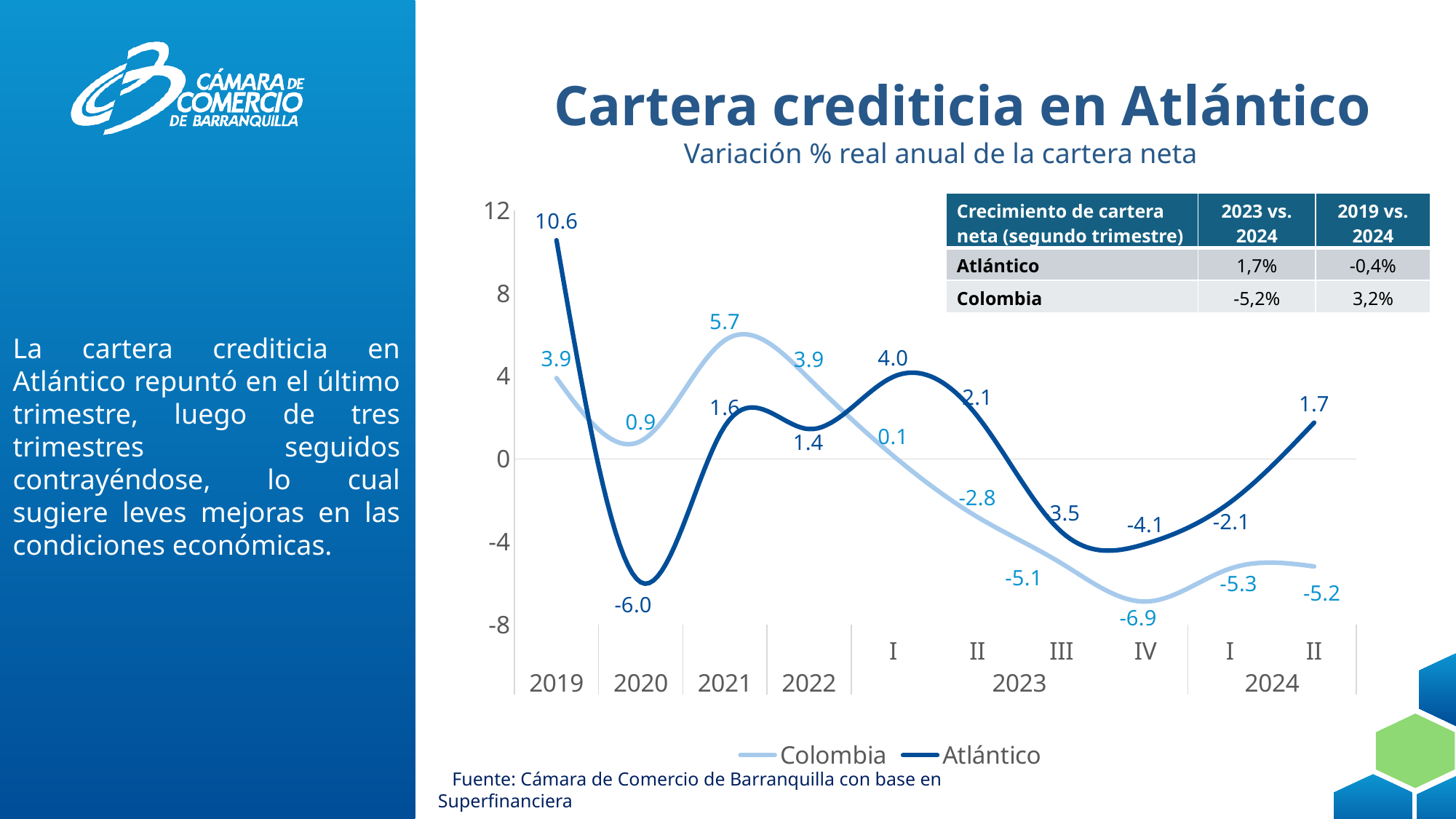
How many series does the chart legend list? 2 What is the value for Atlántico in the second quarter (II) of 2024? 1.7 In 2021, which series has the higher value, Colombia or Atlántico? Colombia What kind of chart is shown on the slide? line chart What is the value for Colombia in the fourth quarter (IV) of 2023? -6.9 What is the value for Atlántico in 2019? 10.6 In which period does the Colombia series reach its lowest value? IV 2023 In which period does the Atlántico series reach its lowest value? 2020 What is the value for Colombia in 2020? 0.9 How many time periods are plotted along the x axis? 10 What is the difference between the Atlántico and Colombia values in the second quarter (II) of 2024? 6.9 In which period does the Atlántico series reach its highest value? 2019